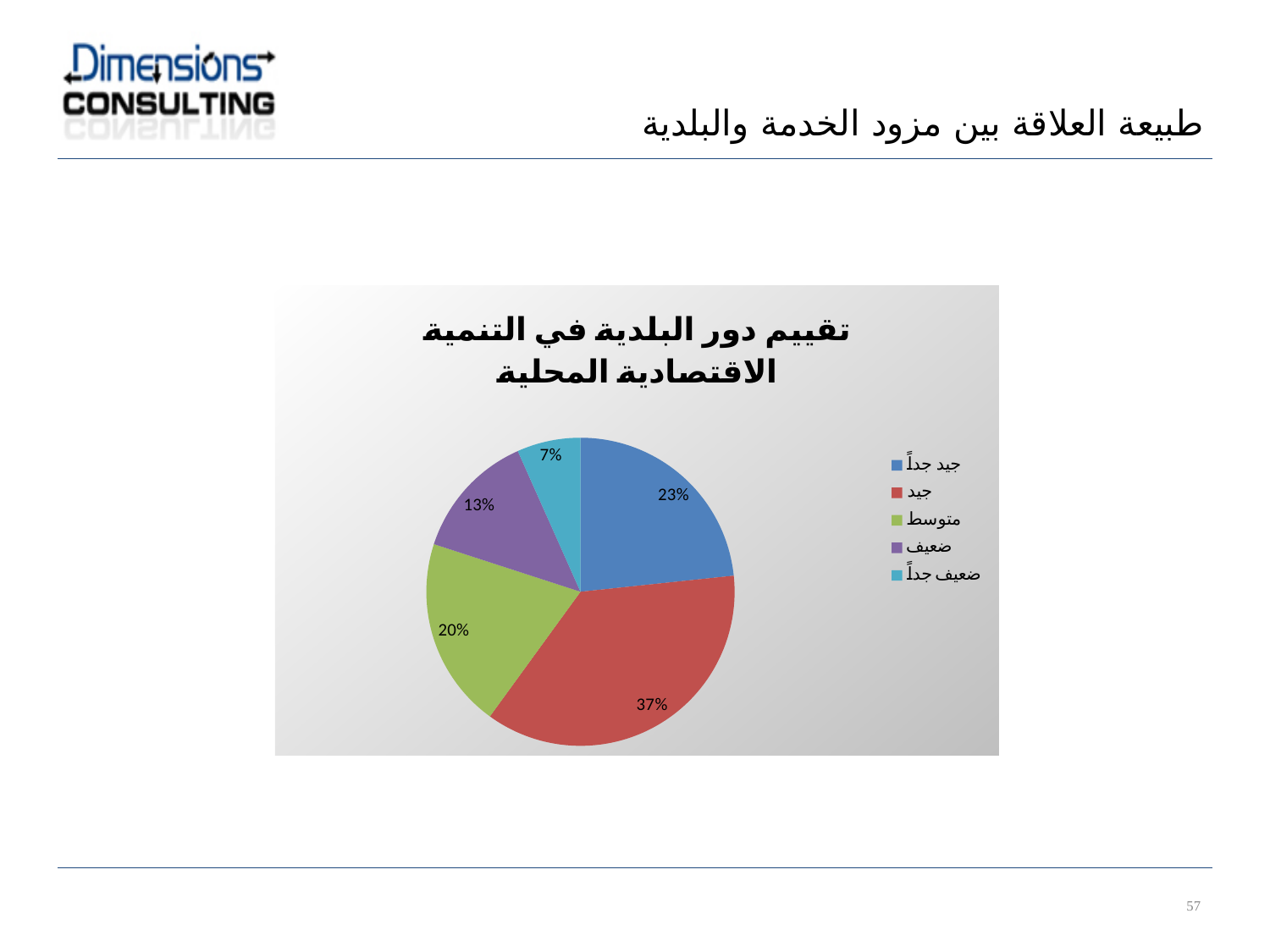
What share of the pie is labelled جيد? 37% What share of the pie is labelled جيد جداً? 23% What share of the pie is labelled ضعيف? 13% Which category has the largest slice of the pie? جيد How many slices does the pie chart have? 5 Which category has the smallest slice of the pie? ضعيف جداً What kind of chart is shown on the slide? Pie chart Which is larger, the slice for متوسط or the slice for ضعيف? متوسط What is the difference in percentage points between the جيد slice and the جيد جداً slice? 14% What is the title of the chart? تقييم دور البلدية في التنمية الاقتصادية المحلية